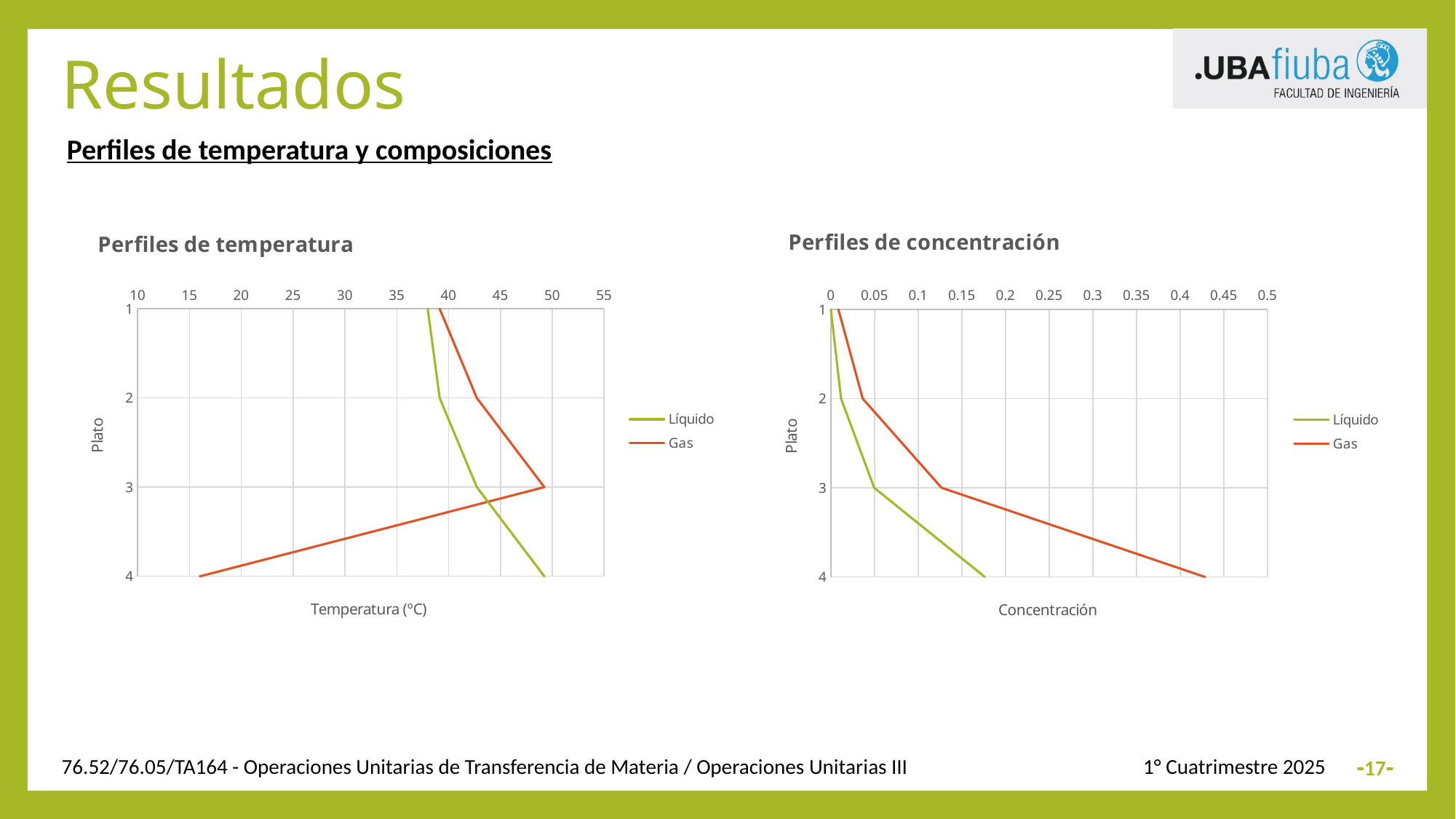
In the 'Perfiles de concentración' chart, which series has the larger concentration at plato 3, Líquido or Gas? Gas How many platos (plates) are plotted on the vertical axis of the 'Perfiles de temperatura' chart? 4 In the 'Perfiles de temperatura' chart, is the Líquido temperature at plato 4 greater or less than 45? greater In the 'Perfiles de temperatura' chart, at which plato is the Gas temperature lowest? 4 What is the horizontal axis title of the 'Perfiles de concentración' chart? Concentración How many series does the legend of the 'Perfiles de concentración' chart list? 2 In the 'Perfiles de temperatura' chart, which series has the higher temperature at plato 3, Líquido or Gas? Gas In the 'Perfiles de concentración' chart, is the Líquido concentration at plato 4 greater or less than 0.2? less What type of chart is the 'Perfiles de temperatura' chart? line chart In the 'Perfiles de temperatura' chart, which series has the higher temperature at plato 4, Líquido or Gas? Líquido In the 'Perfiles de temperatura' chart, is the Gas temperature at plato 4 greater or less than 20? less